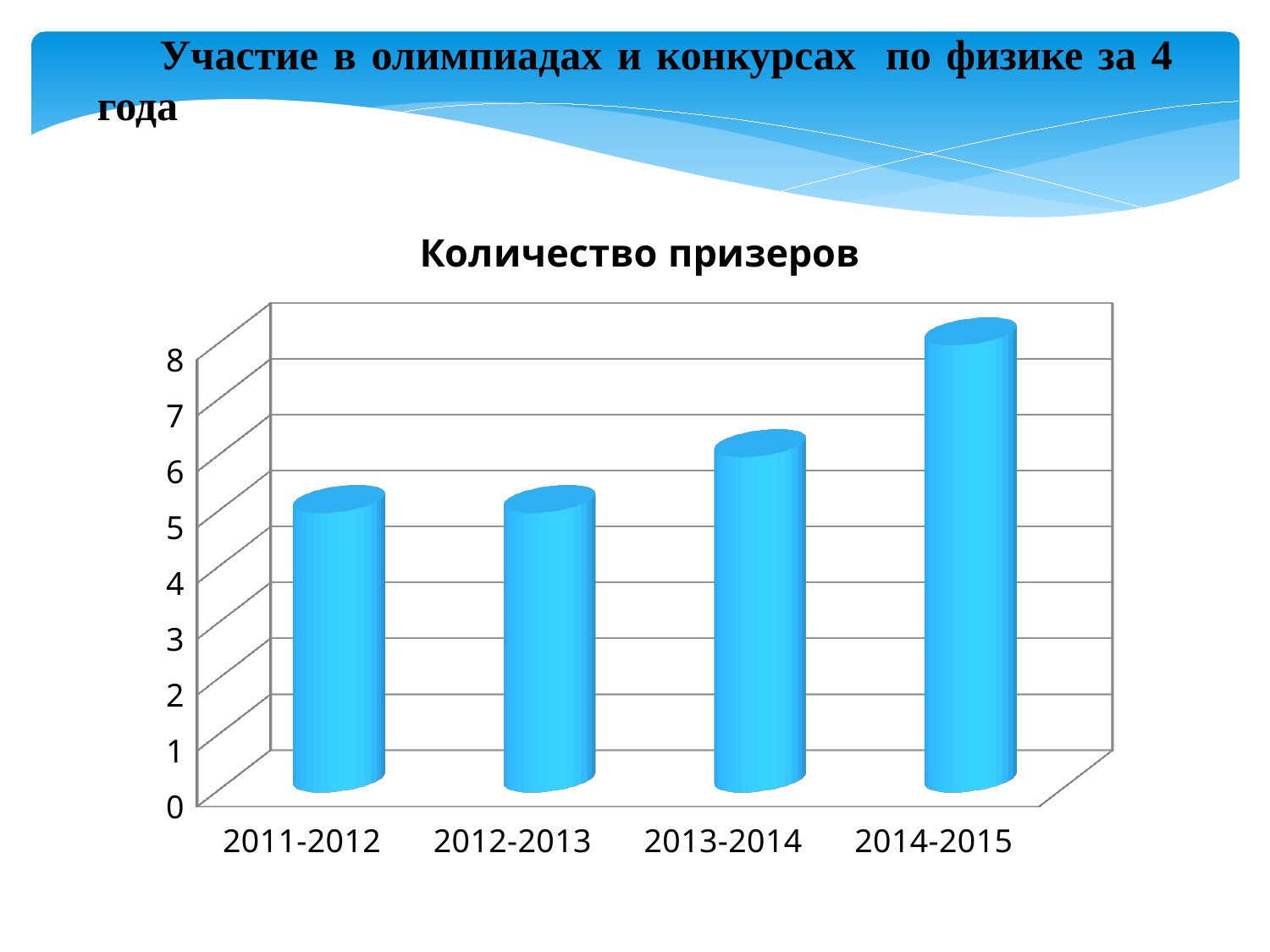
Is the value for 2011-2012 greater or less than 6? less Is the value for 2012-2013 greater or less than 7? less Do the values generally rise or fall from 2011-2012 to 2014-2015? rise What is the highest value shown on the vertical axis? 8 How many categories (school years) are shown on the x axis? 4 What is the title of the chart? Количество призеров Is the value for 2013-2014 greater or less than 5? greater What type of chart is shown on the slide? bar chart Which is larger, the value for 2013-2014 or the value for 2012-2013? 2013-2014 Which is larger, the value for 2014-2015 or the value for 2011-2012? 2014-2015 Which school year has the highest number of prize winners? 2014-2015